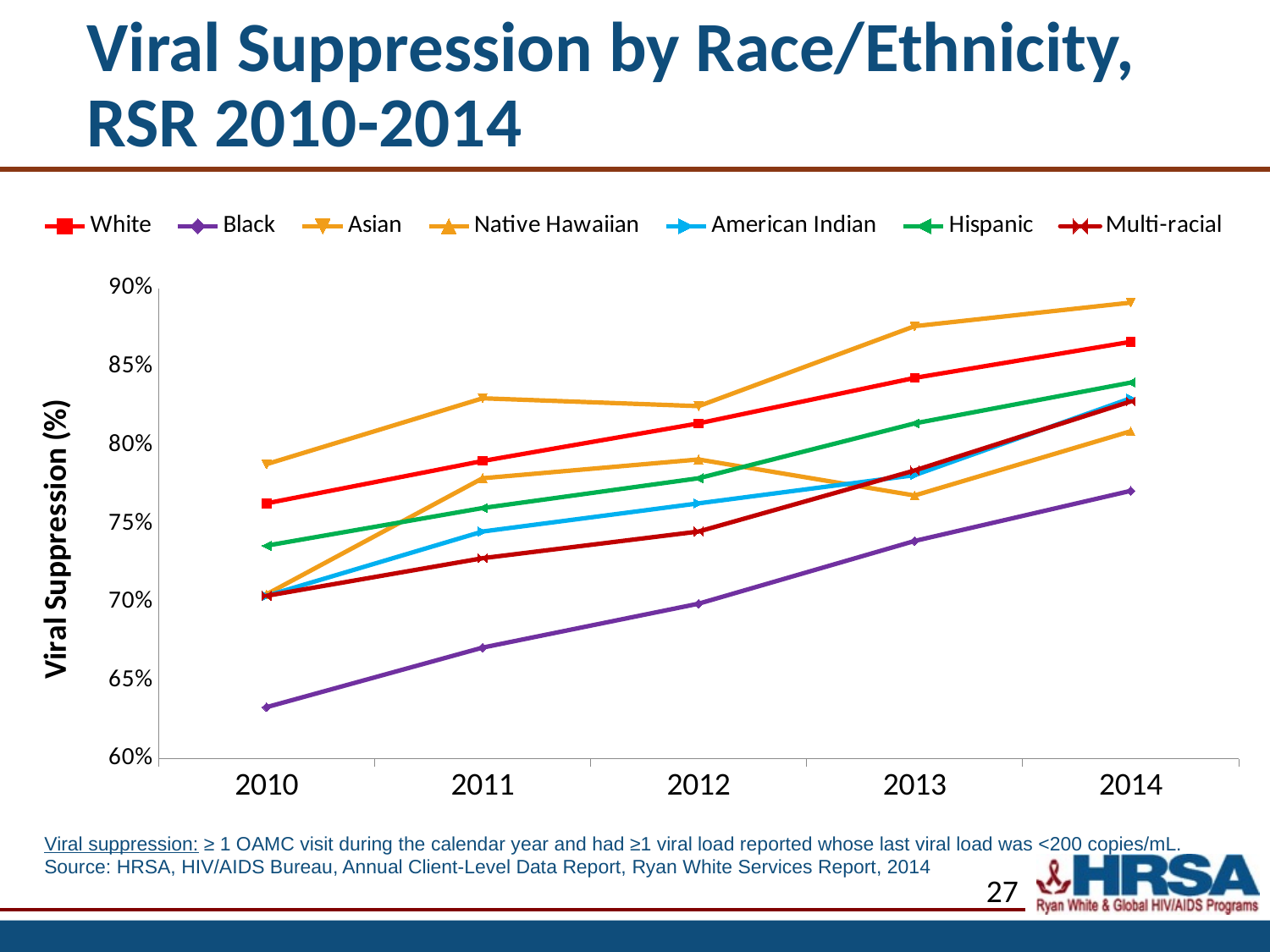
In 2012, which has the higher viral suppression, White or Black? White Which race/ethnicity group has the highest viral suppression in 2014? Asian Which race/ethnicity group has the lowest viral suppression in 2014? Black Does the viral suppression for Black rise or fall from 2010 to 2014? rise What kind of chart is shown on the slide? line chart Is the viral suppression value for Black in 2014 greater or less than 80%? less Which race/ethnicity group has the lowest viral suppression in 2010? Black How many years are shown on the x axis? 5 Is the viral suppression value for Asian in 2014 greater or less than 85%? greater Is the viral suppression value for Black in 2010 greater or less than 65%? less What is the title of the chart? Viral Suppression by Race/Ethnicity, RSR 2010-2014 How many series does the legend list? 7